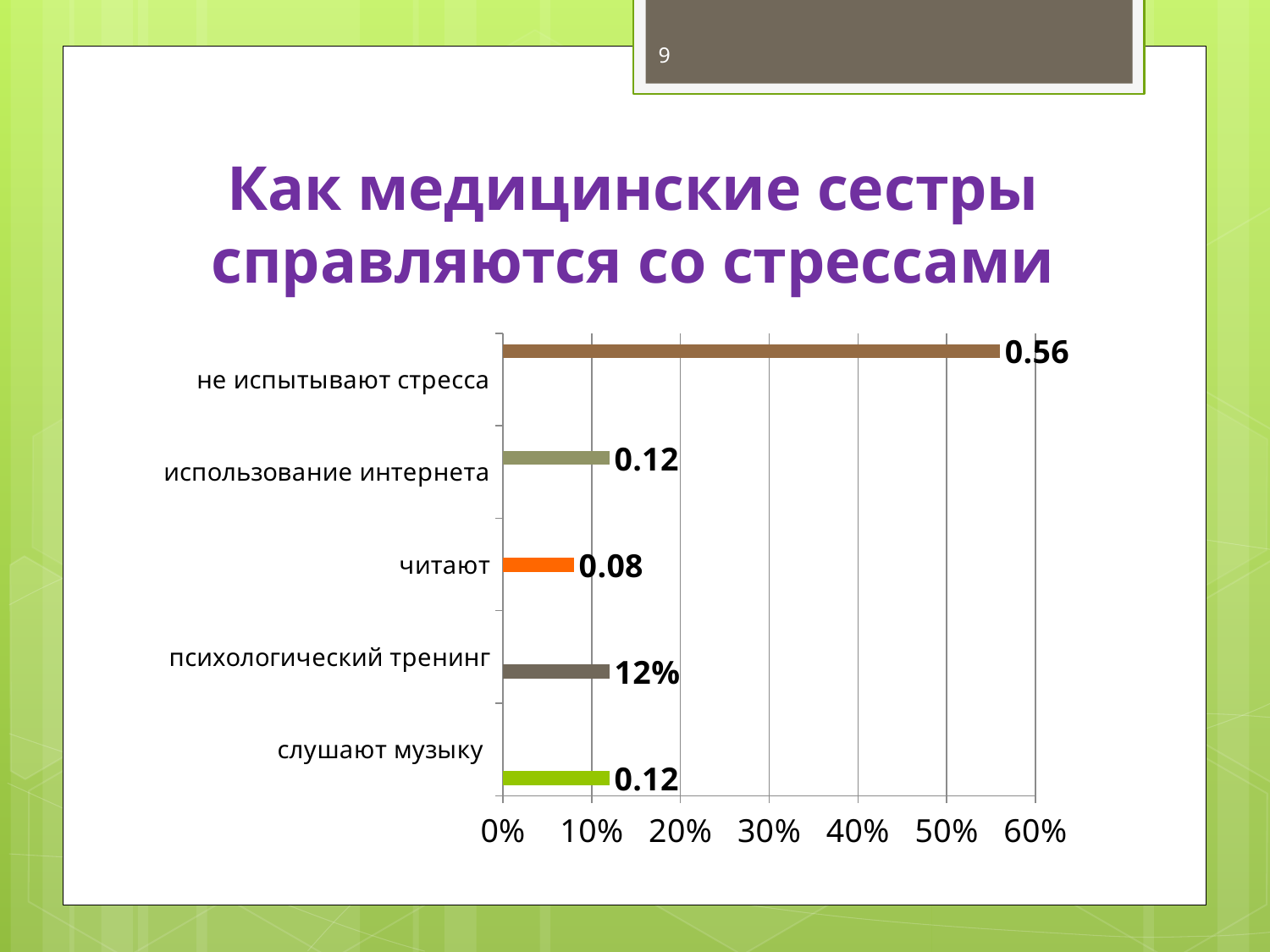
What value is shown for the category "психологический тренинг"? 12% What is the title of the slide? Как медицинские сестры справляются со стрессами What is the difference between the values for "не испытывают стресса" and "использование интернета"? 0.44 What value is shown for the category "не испытывают стресса"? 0.56 Is the value for "не испытывают стресса" greater or less than 50%? greater What value is shown for the category "читают"? 0.08 Which is larger: the value for "использование интернета" or the value for "читают"? использование интернета What value is shown for the category "слушают музыку"? 0.12 How many categories are shown in the chart? 5 What kind of chart is shown on the slide? bar chart Which category has the highest value? не испытывают стресса Which category has the lowest value? читают